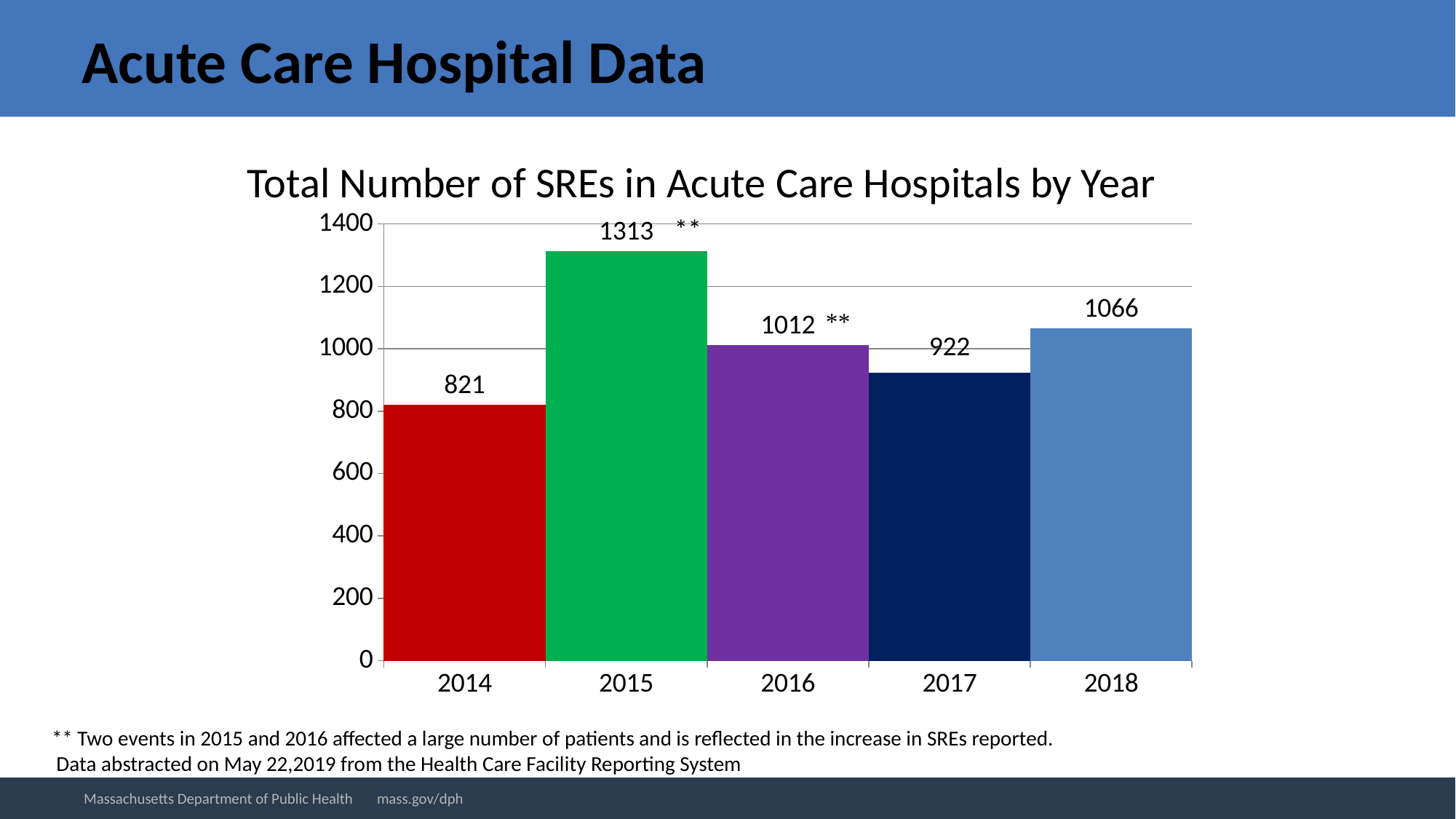
What is the total number of SREs in acute care hospitals in 2018? 1066 Which year has the lowest total number of SREs? 2014 Which year has the highest total number of SREs? 2015 What kind of chart is shown on the slide? Bar chart What is the total number of SREs in acute care hospitals in 2017? 922 What is the title of the chart? Total Number of SREs in Acute Care Hospitals by Year How many years are shown on the chart? 5 Which year had more SREs, 2016 or 2018? 2018 What is the difference between the number of SREs in 2015 and in 2014? 492 What is the total number of SREs in acute care hospitals in 2015? 1313 Is the value for 2017 greater or less than 1000? less What is the difference between the number of SREs in 2018 and in 2017? 144